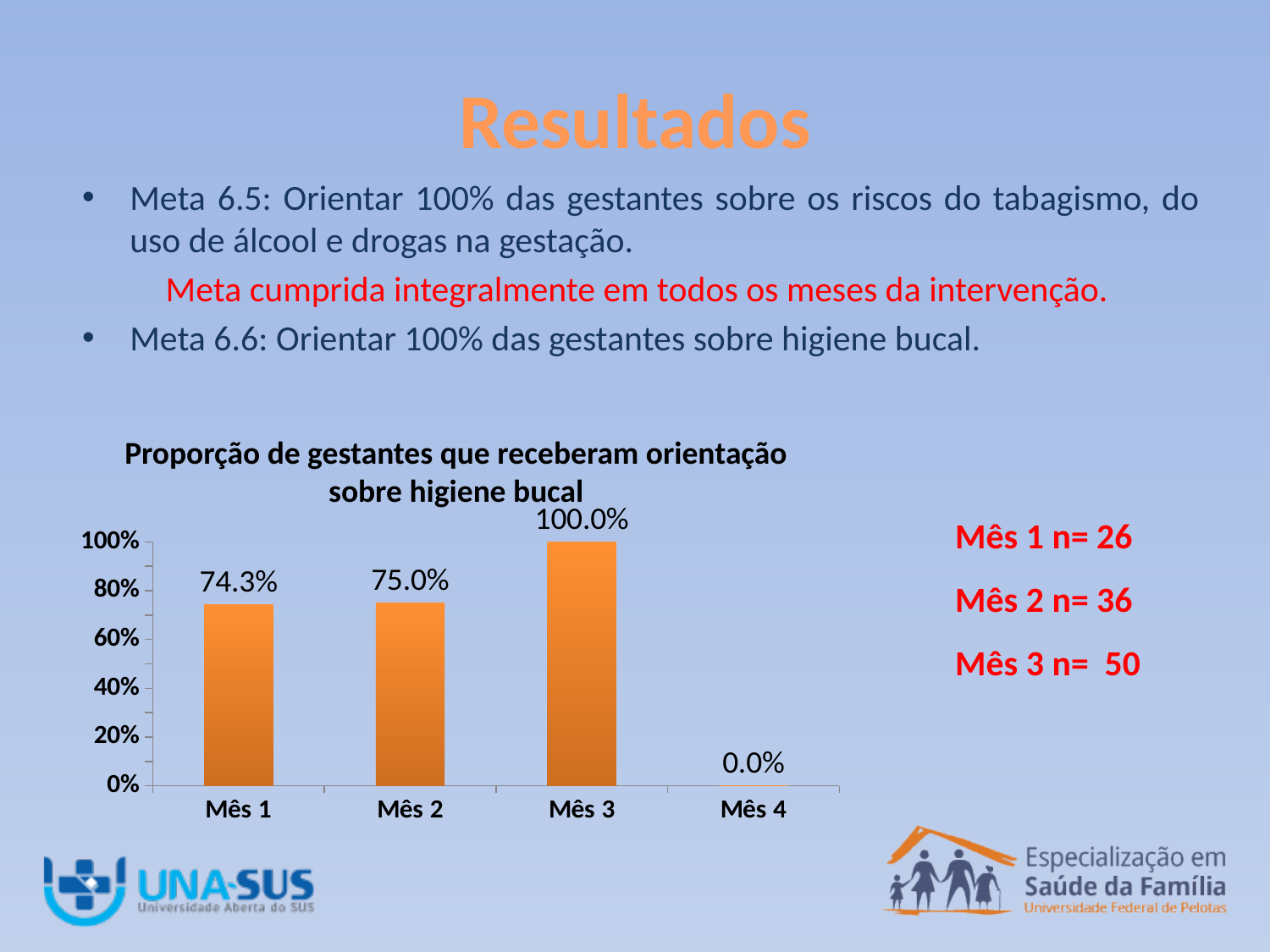
Which month has the highest value? Mês 3 What is the title of the chart? Proporção de gestantes que receberam orientação sobre higiene bucal Is the value for Mês 1 greater or less than 60%? greater What kind of chart is shown? Bar chart What is the value for Mês 2? 75.0% What is the difference between the values for Mês 2 and Mês 1? 0.7% Which month has the lowest value? Mês 4 What is the value for Mês 1? 74.3% What is the value for Mês 3? 100.0% How many months are shown on the x axis? 4 What is the difference between the values for Mês 3 and Mês 1? 25.7% What is the value for Mês 4? 0.0%